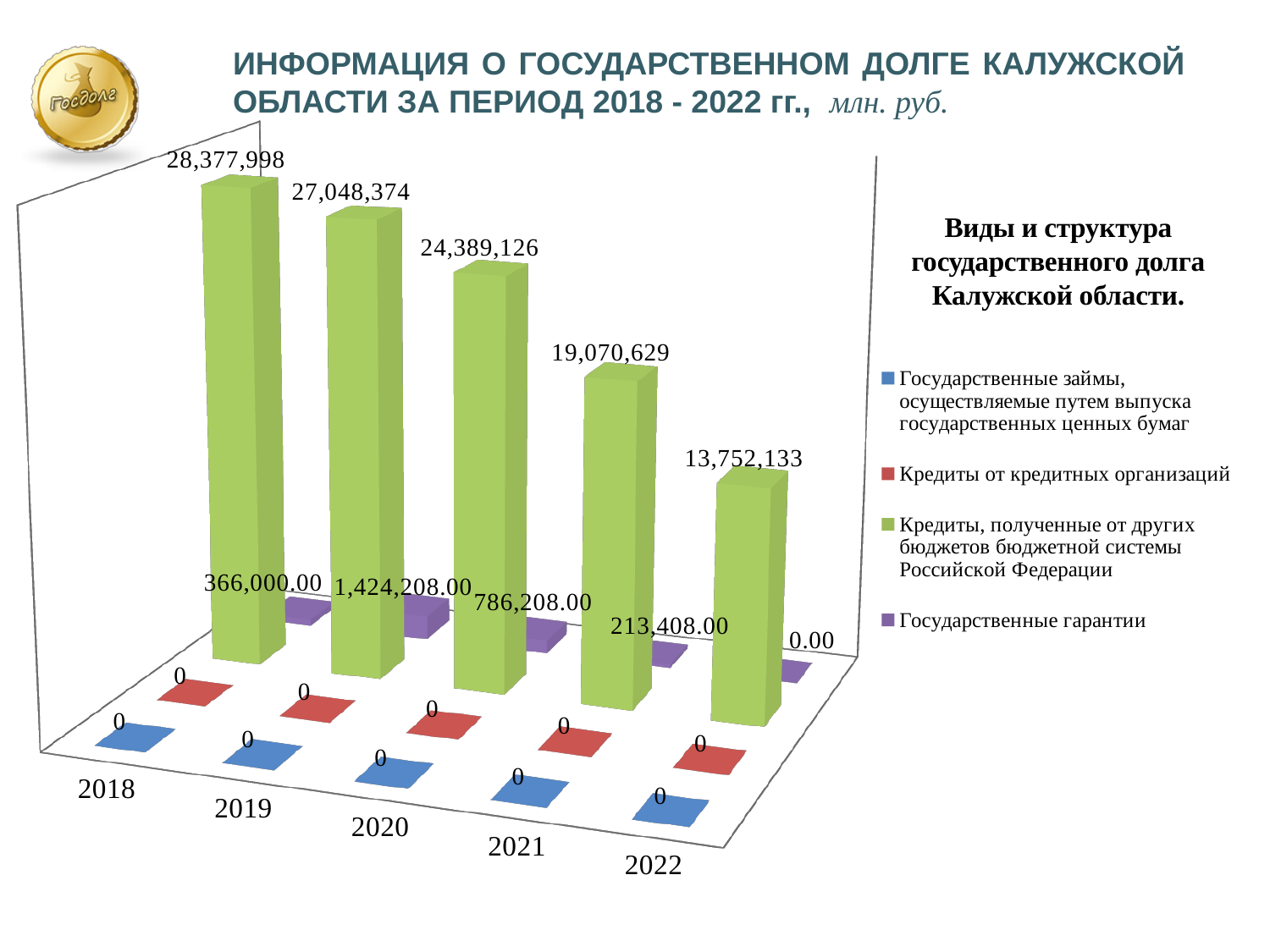
In which year is 'Кредиты, полученные от других бюджетов бюджетной системы Российской Федерации' lowest? 2022 Do the values of 'Кредиты, полученные от других бюджетов бюджетной системы Российской Федерации' rise or fall from 2018 to 2022? fall In which year is 'Государственные гарантии' highest? 2019 What is the value of 'Государственные гарантии' for 2019? 1,424,208.00 Which is larger: 'Государственные гарантии' in 2020 or in 2021? 2020 What kind of chart is shown on the slide? bar chart What is the value of 'Государственные гарантии' for 2022? 0.00 What is the value of 'Кредиты, полученные от других бюджетов бюджетной системы Российской Федерации' for 2018? 28,377,998 How many series does the legend list? 4 What is the value of 'Кредиты, полученные от других бюджетов бюджетной системы Российской Федерации' for 2022? 13,752,133 How many years are shown on the x axis? 5 What is the difference between the 2018 and 2022 values of 'Кредиты, полученные от других бюджетов бюджетной системы Российской Федерации'? 14,625,865